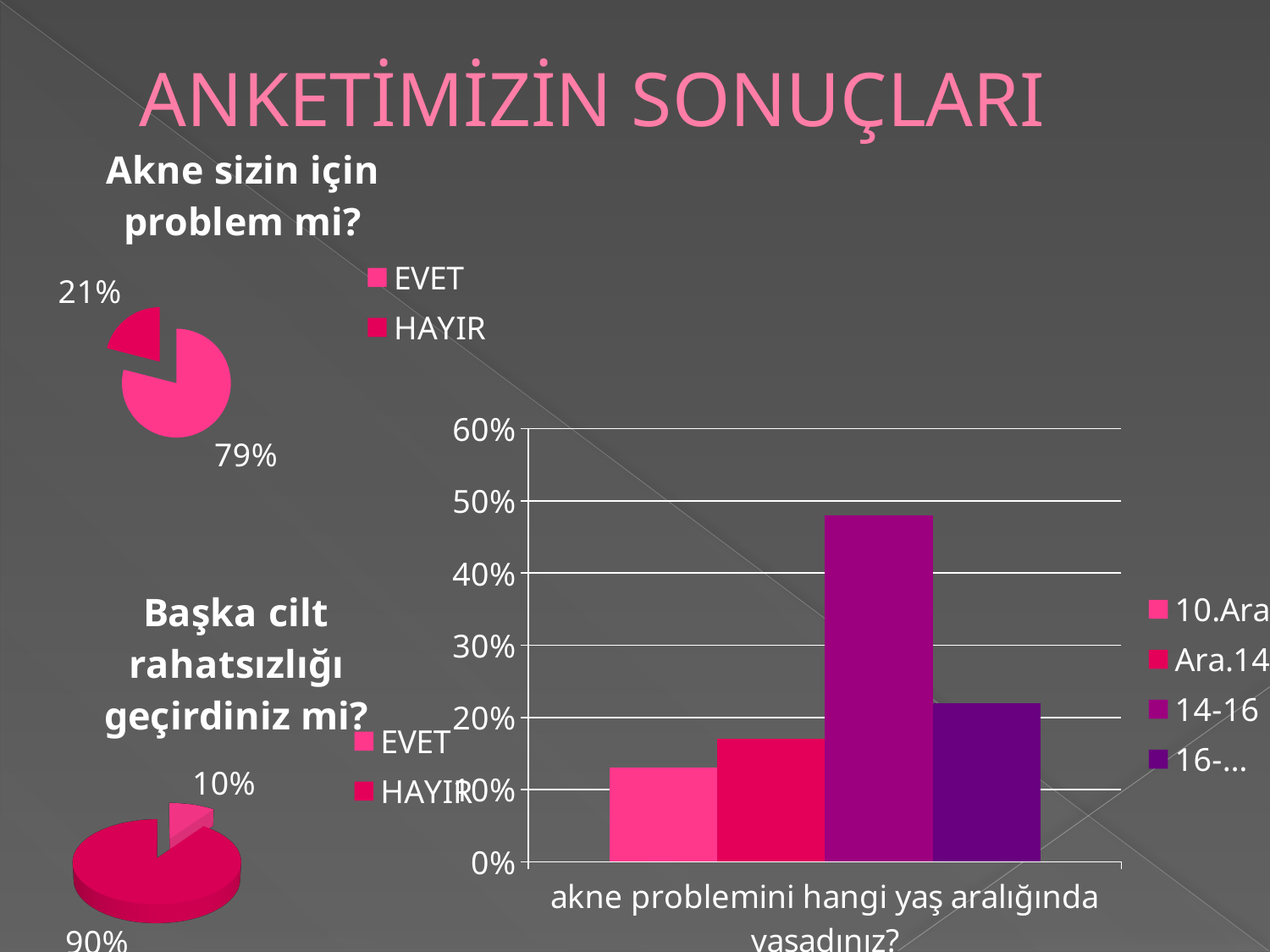
In the pie chart titled "Başka cilt rahatsızlığı geçirdiniz mi?", what percentage is shown for HAYIR? 90% In the bar chart titled "akne problemini hangi yaş aralığında yaşadınız?", how many series does the legend list? 4 In the pie chart titled "Akne sizin için problem mi?", what percentage is shown for HAYIR? 21% What kind of chart is the chart titled "akne problemini hangi yaş aralığında yaşadınız?"? bar chart In the bar chart titled "akne problemini hangi yaş aralığında yaşadınız?", which series has the highest bar? 14-16 In the pie chart titled "Akne sizin için problem mi?", which slice is larger, EVET or HAYIR? EVET In the pie chart titled "Başka cilt rahatsızlığı geçirdiniz mi?", what percentage is shown for EVET? 10% In the bar chart titled "akne problemini hangi yaş aralığında yaşadınız?", which series has the lowest bar? 10.Ara In the bar chart titled "akne problemini hangi yaş aralığında yaşadınız?", is the value for 10.Ara greater or less than 20%? less In the pie chart titled "Akne sizin için problem mi?", what percentage is shown for EVET? 79% In the bar chart titled "akne problemini hangi yaş aralığında yaşadınız?", is the value for 14-16 greater or less than 40%? greater In the pie chart titled "Akne sizin için problem mi?", what is the difference between the EVET and HAYIR percentages? 58%